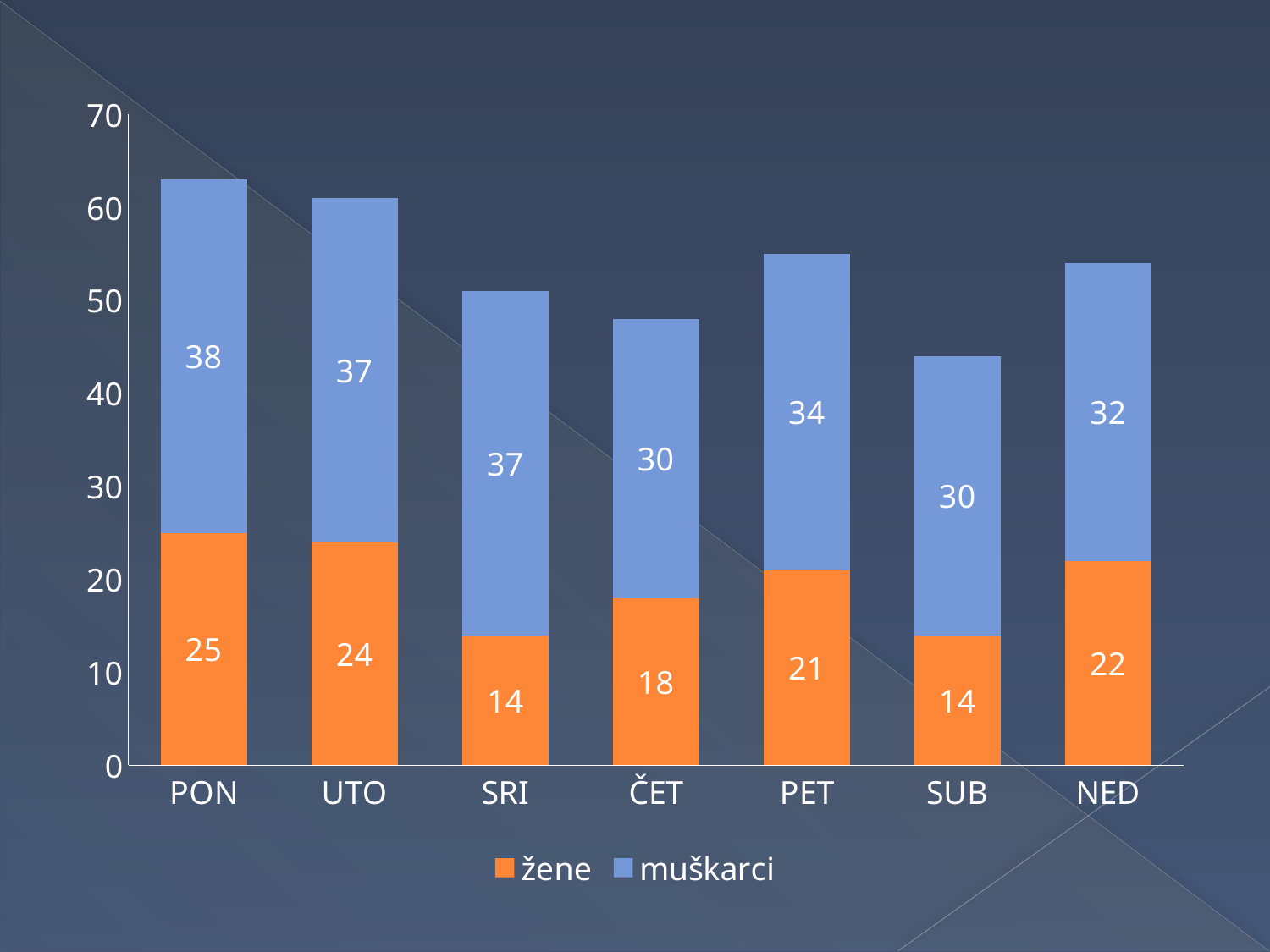
What is the difference between the muškarci and žene values on ČET? 12 How many series does the legend list? 2 Is the žene value on UTO larger than the žene value on NED? Yes, UTO What kind of chart is this? Stacked bar chart What is the value for žene on PON? 25 What is the value for žene on SUB? 14 What is the total of the stacked bar for SUB? 44 What is the total of the stacked bar for PON? 63 Which day has the lowest value for žene? SRI and SUB Which day has the highest value for muškarci? PON How many days are shown on the x axis? 7 What is the value for muškarci on PET? 34